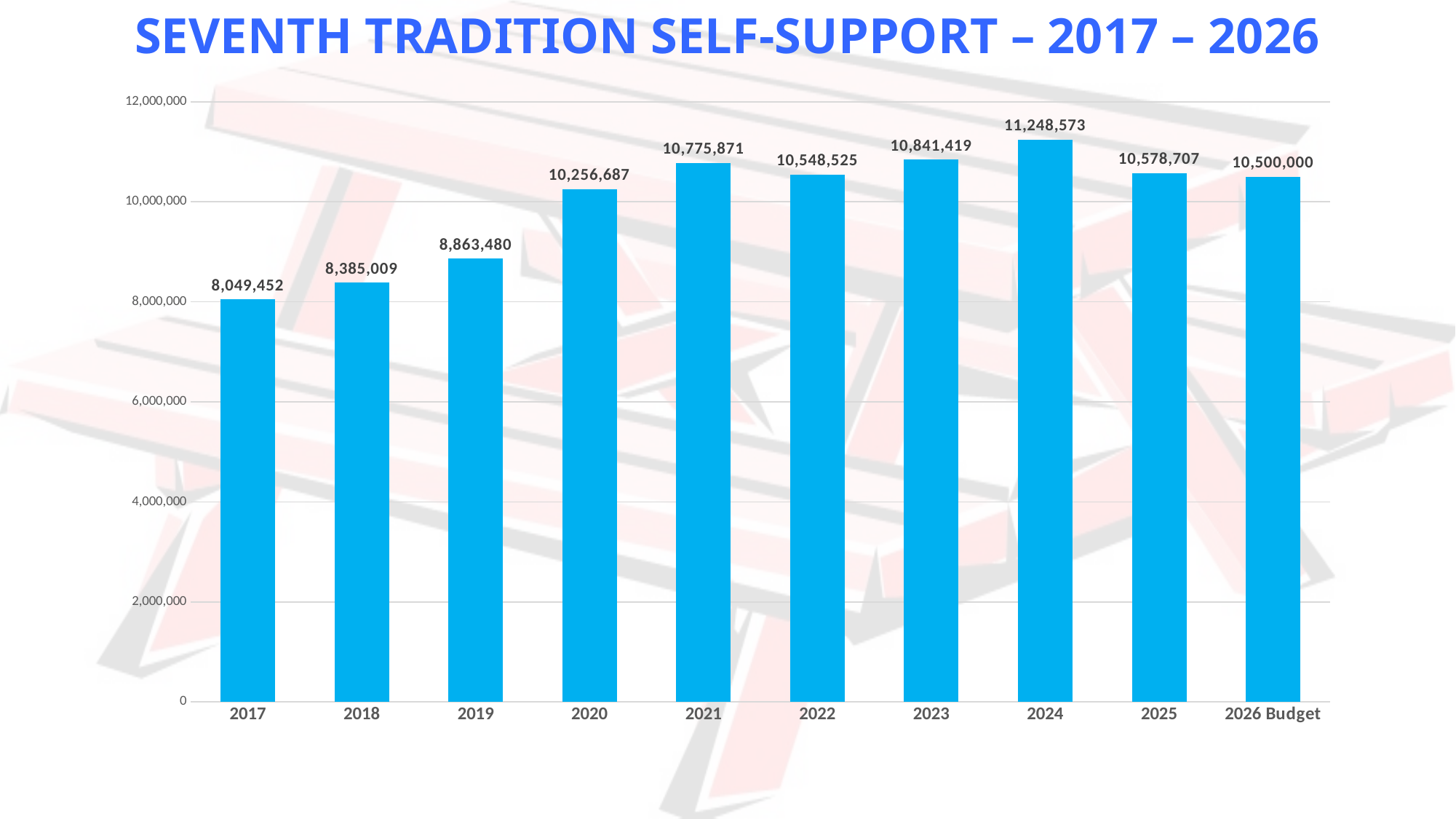
Which is larger, the value for 2022 or the value for 2023? 2023 What kind of chart is shown on the slide? bar chart What is the value for 2024? 11,248,573 Is the value for 2019 greater or less than 10,000,000? less What is the difference between the values for 2024 and 2017? 3,199,121 What is the difference between the values for 2021 and 2020? 519,184 How many bars are shown in the chart? 10 Which year has the highest value? 2024 Which year has the lowest value? 2017 What is the value for 2026 Budget? 10,500,000 What is the title of the chart? SEVENTH TRADITION SELF-SUPPORT – 2017 – 2026 What is the value for 2017? 8,049,452